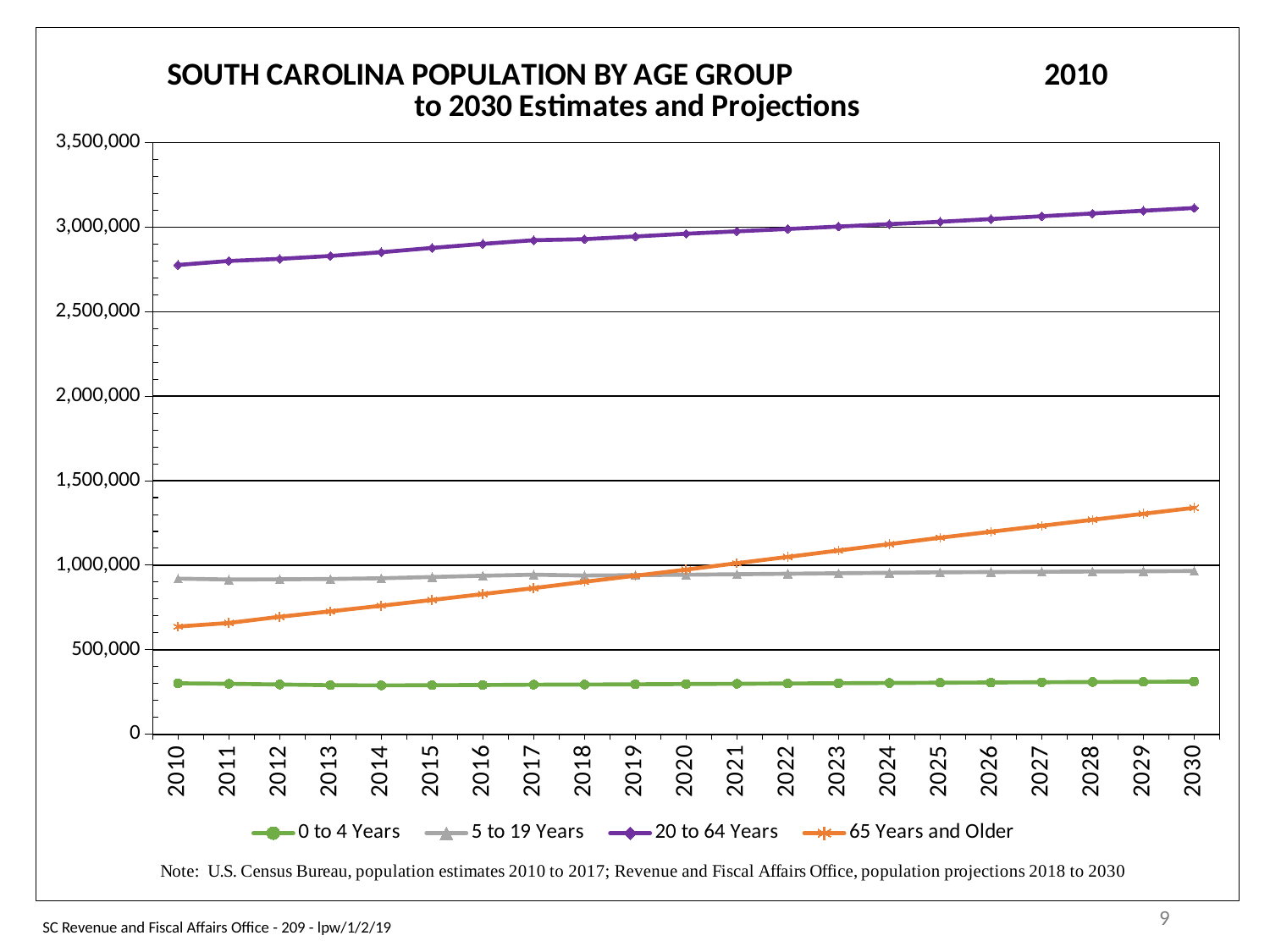
Which age group has the highest population in 2030? 20 to 64 Years In 2010, which is larger: the population of 5 to 19 Years or of 65 Years and Older? 5 to 19 Years Is the value for 20 to 64 Years in 2010 greater or less than 3,000,000? less Is the value for 20 to 64 Years in 2030 greater or less than 3,000,000? greater How many series does the legend list? 4 Is the value for 65 Years and Older in 2010 greater or less than 1,000,000? less In 2030, which is larger: the population of 65 Years and Older or of 5 to 19 Years? 65 Years and Older What kind of chart is shown on the slide? line chart Which age group has the lowest population in 2010? 0 to 4 Years How many years are plotted along the x axis? 21 Does the population of the 65 Years and Older group rise or fall from 2010 to 2030? rise